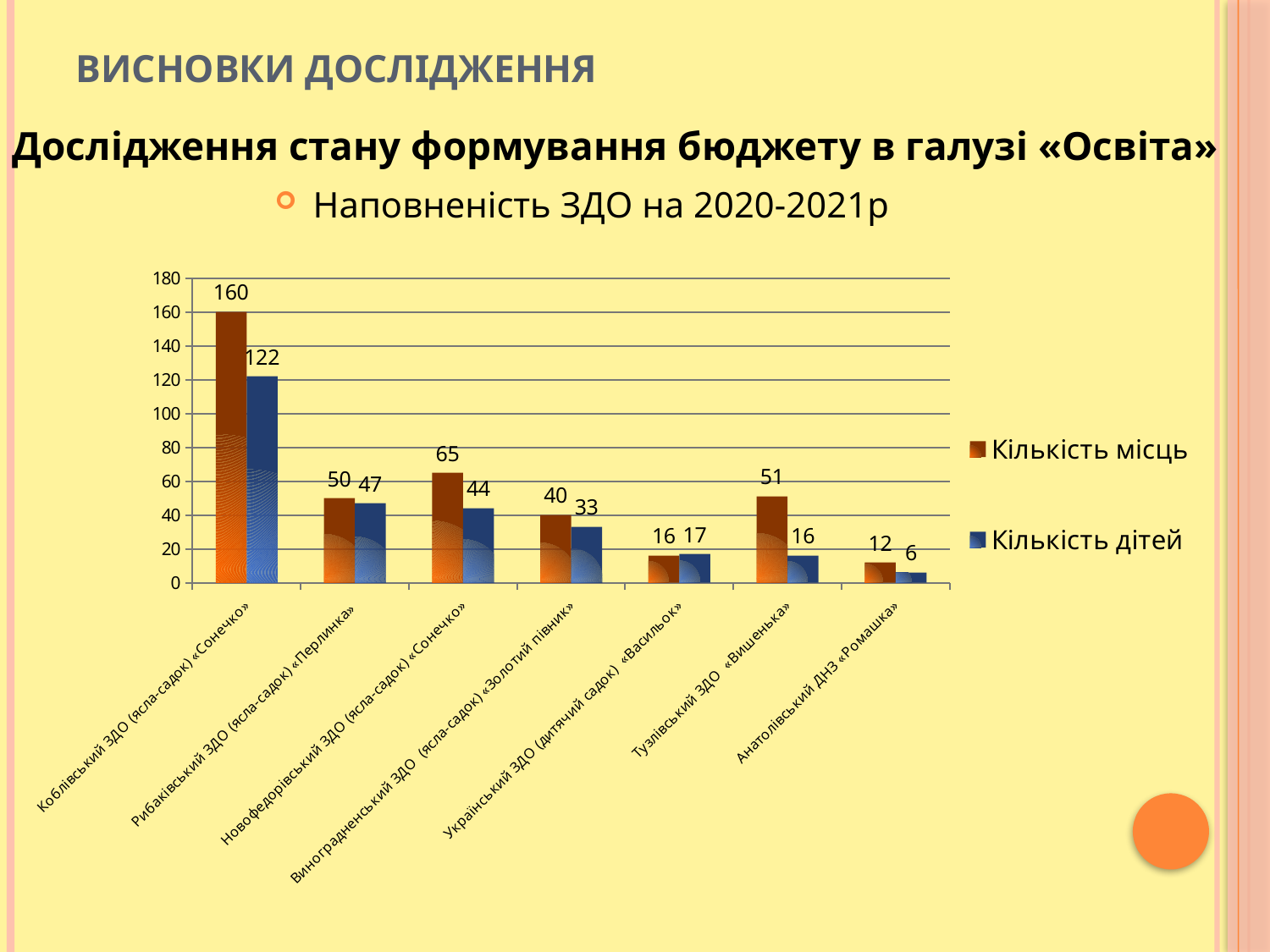
Which institution has the highest value for «Кількість місць»? Коблівський ЗДО (ясла-садок) «Сонечко» What kind of chart is shown on the slide? bar chart For Український ЗДО (дитячий садок) «Васильок», which is larger: «Кількість місць» or «Кількість дітей»? Кількість дітей Which series is shown in blue in the legend? Кількість дітей Which institution has the lowest value for «Кількість дітей»? Анатолівський ДНЗ «Ромашка» What is the value of «Кількість місць» for Коблівський ЗДО (ясла-садок) «Сонечко»? 160 What is the value of «Кількість дітей» for Тузлівський ЗДО «Вишенька»? 16 What is the difference between «Кількість місць» and «Кількість дітей» for Тузлівський ЗДО «Вишенька»? 35 What is the difference between «Кількість місць» and «Кількість дітей» for Коблівський ЗДО (ясла-садок) «Сонечко»? 38 How many categories (institutions) are shown on the x axis? 7 What is the value of «Кількість дітей» for Новофедорівський ЗДО (ясла-садок) «Сонечко»? 44 How many series does the legend list? 2